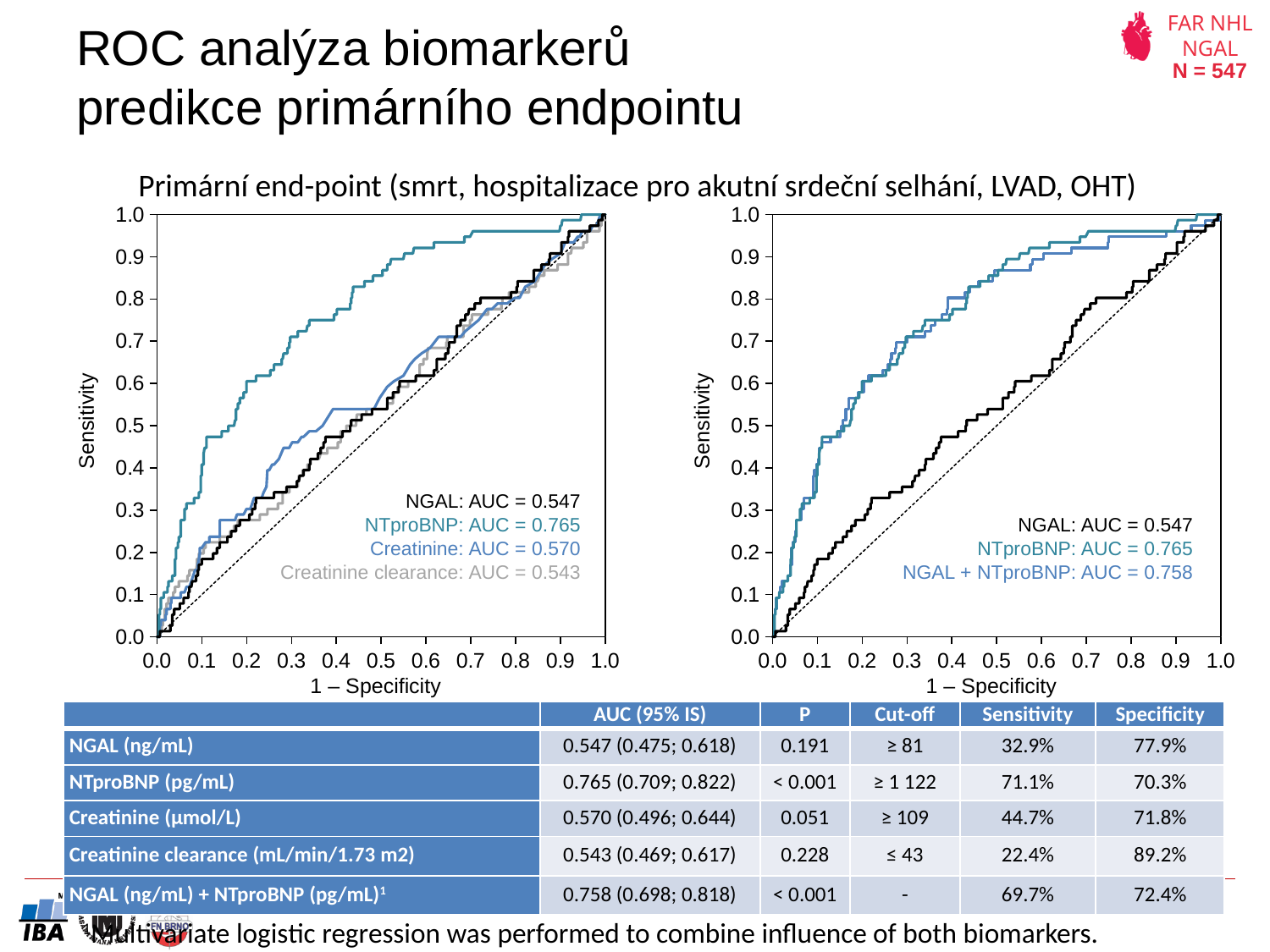
On the right chart, how many biomarker curves are listed with an AUC value? 3 On the left chart, which biomarker has the highest printed AUC? NTproBNP What is the label of the vertical axis on the right chart? Sensitivity What kind of chart is shown on the left of the slide? Line chart (ROC curve) On the right chart, what is the AUC printed for NGAL? 0.547 On the left chart, which biomarker has the lowest printed AUC? Creatinine clearance On the left chart, what is the difference between the printed AUC of NTproBNP and the printed AUC of NGAL? 0.218 On the right chart, what is the AUC printed for NGAL + NTproBNP? 0.758 On the left chart, how many biomarker curves are listed with an AUC value? 4 On the left chart, what is the AUC printed for NTproBNP? 0.765 On the right chart, which has the larger printed AUC, NTproBNP or NGAL + NTproBNP? NTproBNP On the left chart, what is the AUC printed for Creatinine clearance? 0.543